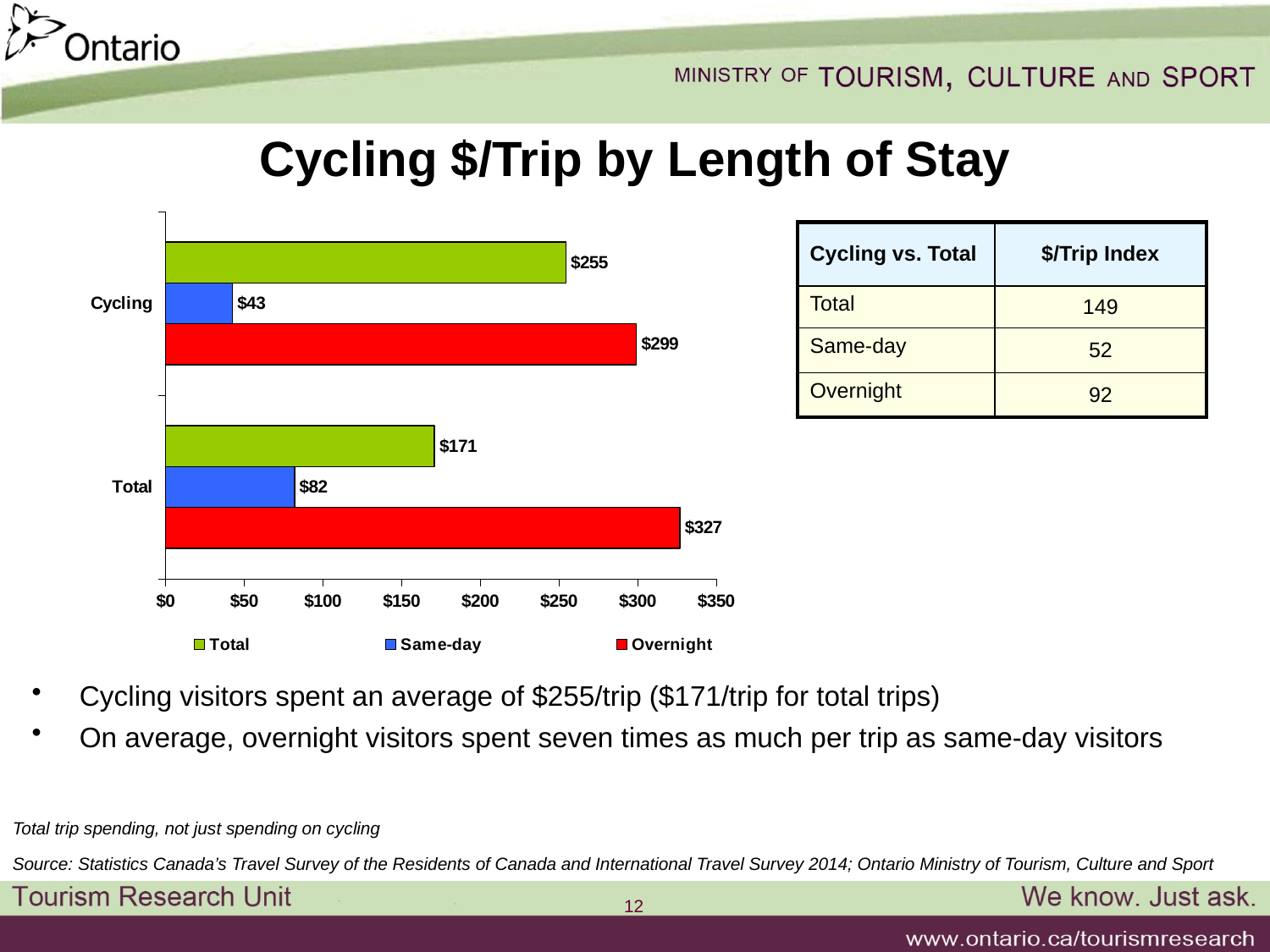
What is the Total series value for Cycling? $255 What is the difference between the Overnight values for Total and Cycling? $28 What kind of chart is shown on the slide? bar chart Which series has the lowest value for the Cycling category? Same-day Which series has the highest value for the Total category? Overnight Is the Overnight value for Total greater or less than $300? greater Which is larger, the Same-day value for Cycling or the Same-day value for Total? Total How many categories are shown on the chart? 2 What is the difference between the Total series values for Cycling and Total? $84 What is the Overnight value for Cycling? $299 What is the Same-day value for Total? $82 How many series does the legend list? 3